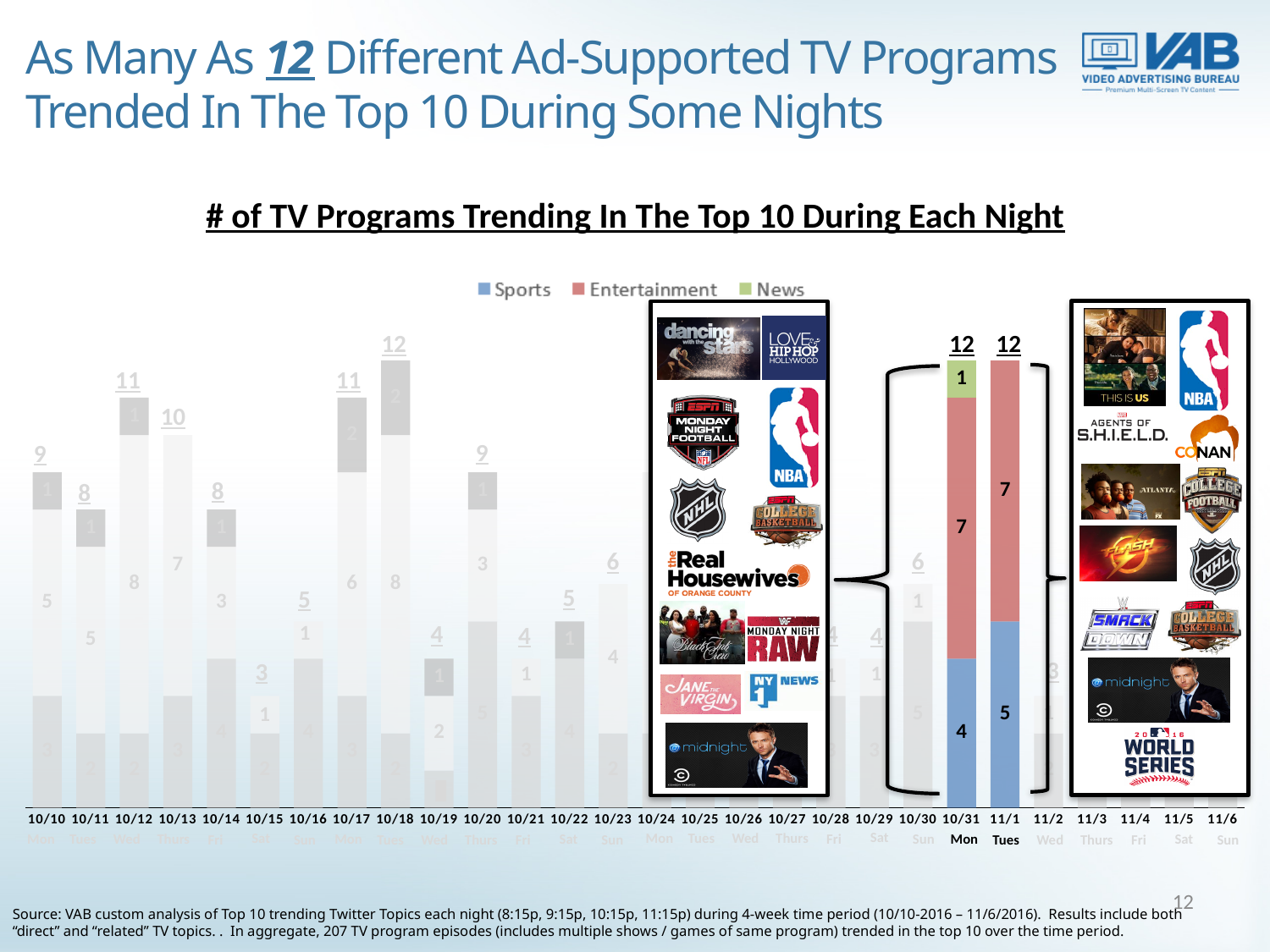
What kind of chart is shown on the slide? Stacked bar chart What is the total number of TV programs trending on 11/1? 12 Which night has the larger Sports value, 10/31 or 11/1? 11/1 What is the difference between the Entertainment and Sports values on 10/31? 3 What is the total number of TV programs trending on 10/31? 12 How many series does the legend list? 3 What is the News value for 10/31? 1 What is the highest nightly total shown on the chart? 12 What is the title of the chart? # of TV Programs Trending In The Top 10 During Each Night What is the Entertainment value for 11/1? 7 What is the Sports value for 10/31? 4 What are the three series named in the legend? Sports, Entertainment, News